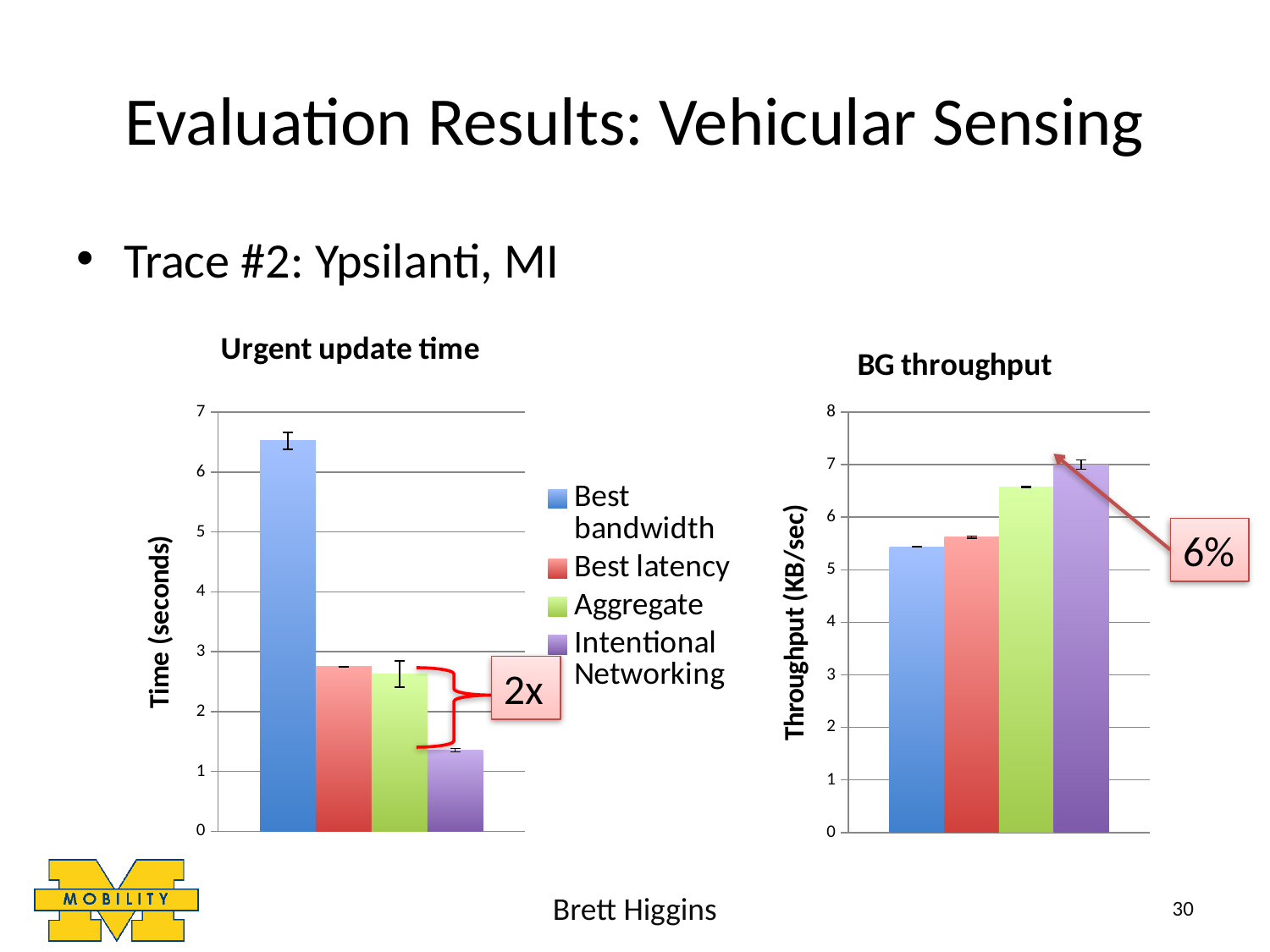
What kind of chart is the "Urgent update time" chart? bar chart What is the y-axis title of the "BG throughput" chart? Throughput (KB/sec) In the "Urgent update time" chart, which series has the highest value? Best bandwidth How many series does the legend list for the charts on this slide? 4 In the "BG throughput" chart, which is larger, the value for Aggregate or the value for Best bandwidth? Aggregate What is the y-axis title of the "Urgent update time" chart? Time (seconds) In the "BG throughput" chart, is the value for Intentional Networking greater or less than 6? greater In the "Urgent update time" chart, which series has the lowest value? Intentional Networking In the "BG throughput" chart, which series has the highest value? Intentional Networking In the "Urgent update time" chart, is the value for Intentional Networking greater or less than 2? less In the "Urgent update time" chart, is the value for Best bandwidth greater or less than 6? greater In the "Urgent update time" chart, which is larger, the value for Best latency or the value for Intentional Networking? Best latency